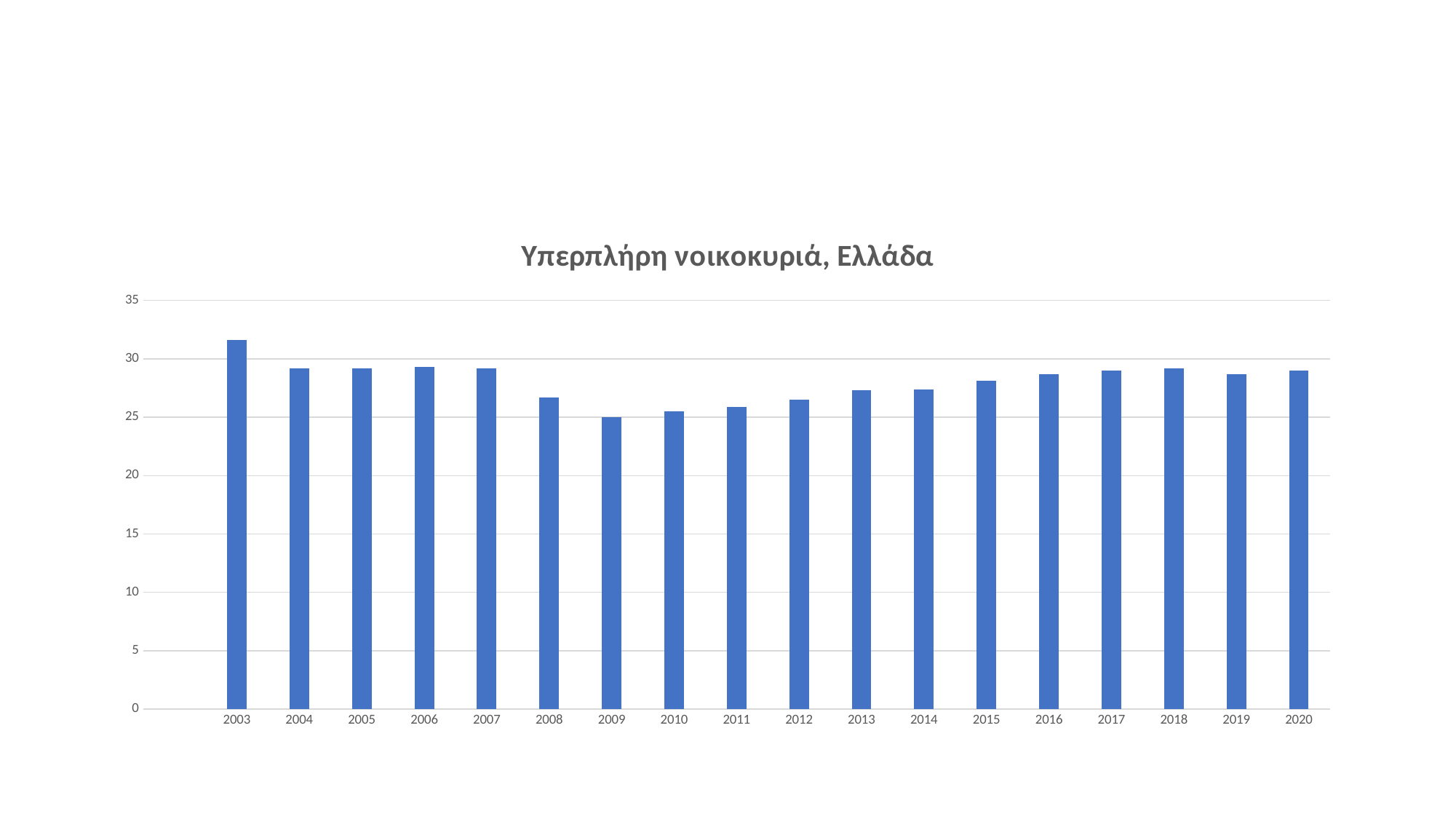
What kind of chart is shown on the slide? bar chart Which year has the lowest bar in the chart? 2009 Is the value for 2008 greater or less than 25? greater What is the title of the chart? Υπερπλήρη νοικοκυριά, Ελλάδα Is the value for 2003 greater or less than 30? greater Do the values rise or fall from 2009 to 2015? rise Which is larger, the value for 2008 or the value for 2015? 2015 Is the value for 2012 greater or less than 30? less Which year has the highest bar in the chart? 2003 How many years are shown on the x axis of the chart? 18 Which is larger, the value for 2003 or the value for 2009? 2003